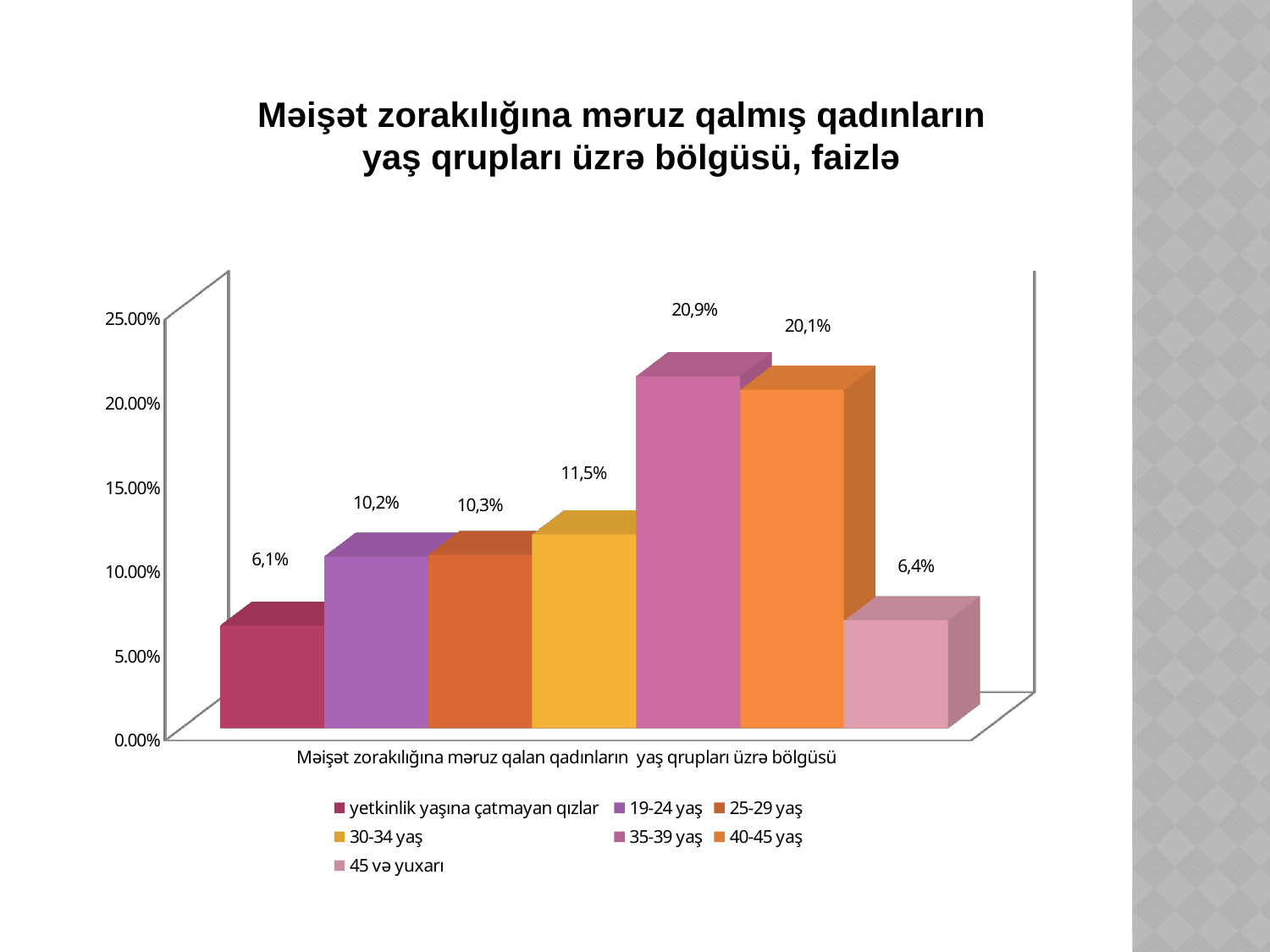
Is the value for 30-34 yaş greater or less than 15.00%? less What is the difference between the values for 30-34 yaş and 25-29 yaş? 1,2% What is the value for the yetkinlik yaşına çatmayan qızlar series? 6,1% What is the value for the 35-39 yaş series? 20,9% Which age group has the lowest value? yetkinlik yaşına çatmayan qızlar How many series does the legend list? 7 What kind of chart is shown on the slide? bar chart Which age group has the highest value? 35-39 yaş What is the difference between the values for 35-39 yaş and 40-45 yaş? 0,8% Which is larger, the value for 40-45 yaş or the value for 19-24 yaş? 40-45 yaş What is the value for the 45 və yuxarı series? 6,4% What is the value for the 30-34 yaş series? 11,5%